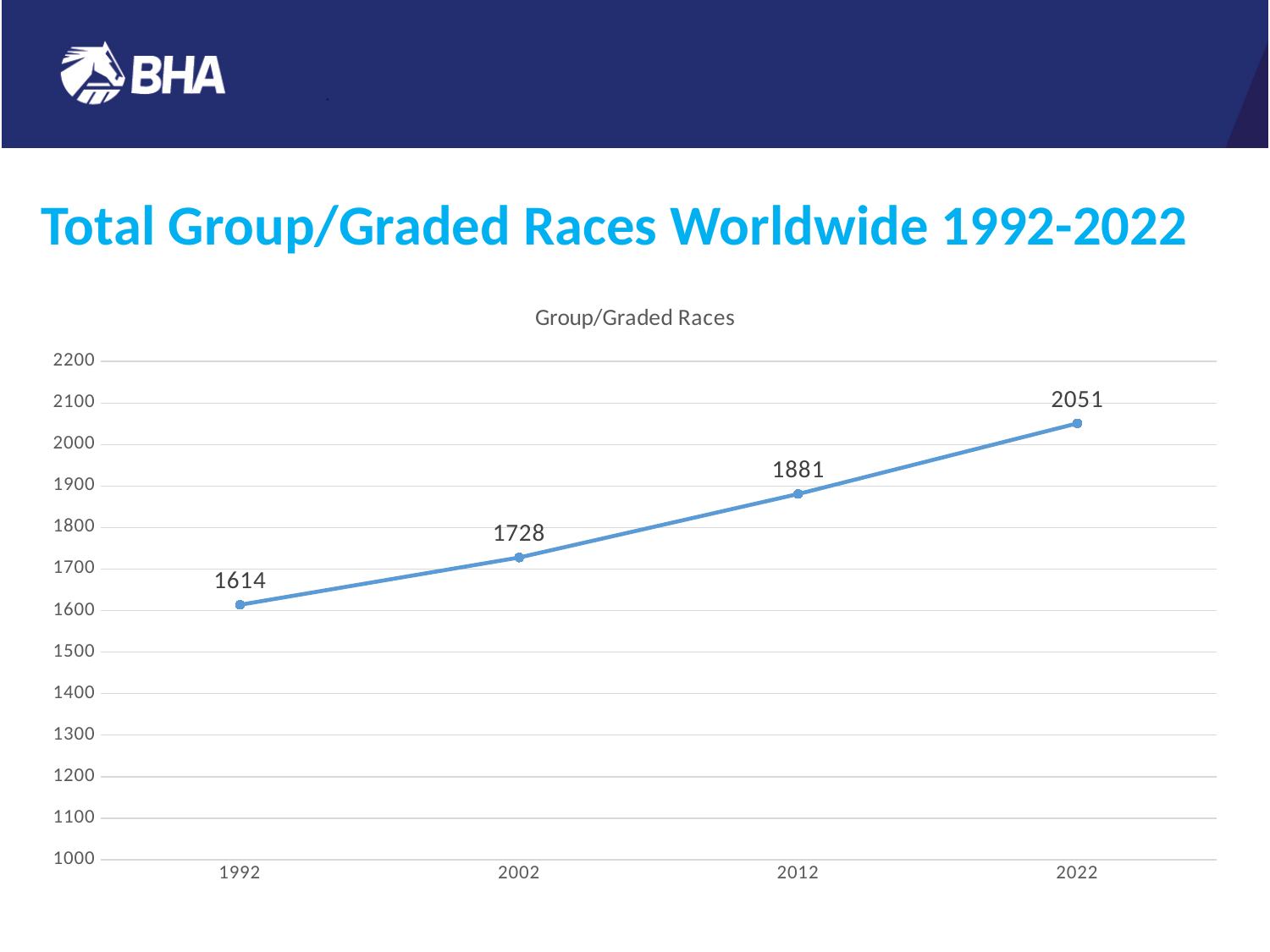
What kind of chart is shown? line chart Which is larger, the value for 2002 or the value for 2012? 2012 What is the difference between the values for 2012 and 2002? 153 What is the value for 2012? 1881 Which year has the lowest value? 1992 What is the value for 1992? 1614 What is the difference between the values for 2022 and 1992? 437 What is the value for 2002? 1728 Which year has the highest value? 2022 How many data points are plotted on the chart? 4 Is the value for 2022 greater or less than 2000? greater What is the value for 2022? 2051